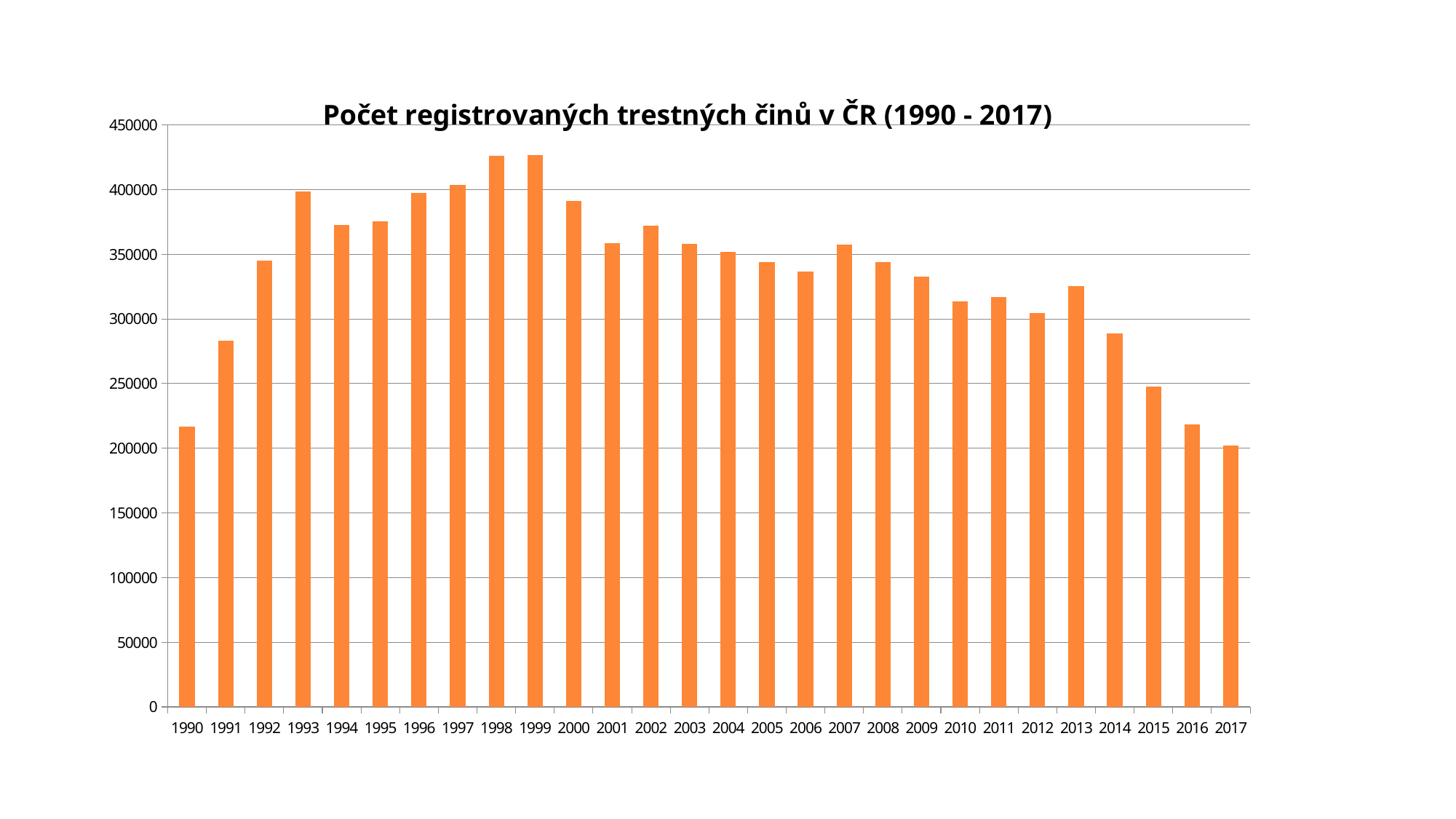
What is the title of the chart? Počet registrovaných trestných činů v ČR (1990 - 2017) What kind of chart is shown on the slide? bar chart Is the value for 2006 greater or less than 350000? less Which year has the lowest value? 2017 Do the values generally rise or fall from 1999 to 2017? fall Is the value for 1990 greater or less than 250000? less Is the value for 2014 greater or less than 300000? less How many years are plotted on the x axis? 28 Which is larger, the value for 1991 or the value for 1992? 1992 Which is larger, the value for 2013 or the value for 2014? 2013